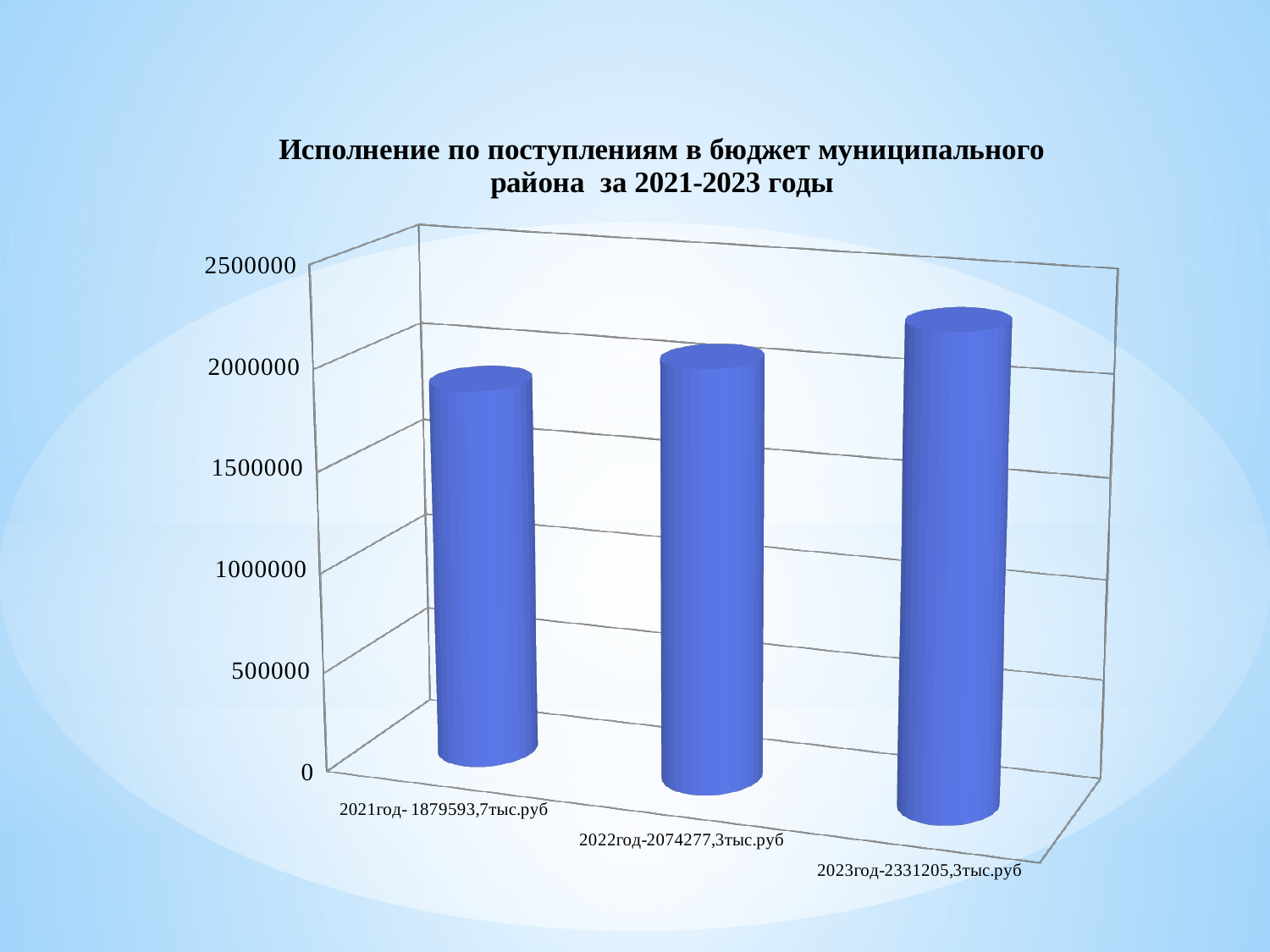
What is the value shown for 2023 (2023год)? 2331205,3тыс.руб What is the difference between the 2022 value and the 2021 value? 194683,6тыс.руб Which is larger, the value for 2022 or the value for 2023? 2023 Do the values rise or fall from 2021 to 2023 along the x axis? rise Which year has the highest value in the chart? 2023год What is the title of the chart? Исполнение по поступлениям в бюджет муниципального района за 2021-2023 годы What is the difference between the 2023 value and the 2021 value? 451611,6тыс.руб What type of chart is shown on the slide? bar chart How many bars (years) are plotted in the chart? 3 What is the value shown for 2021 (2021год)? 1879593,7тыс.руб What is the value shown for 2022 (2022год)? 2074277,3тыс.руб Which year has the lowest value in the chart? 2021год